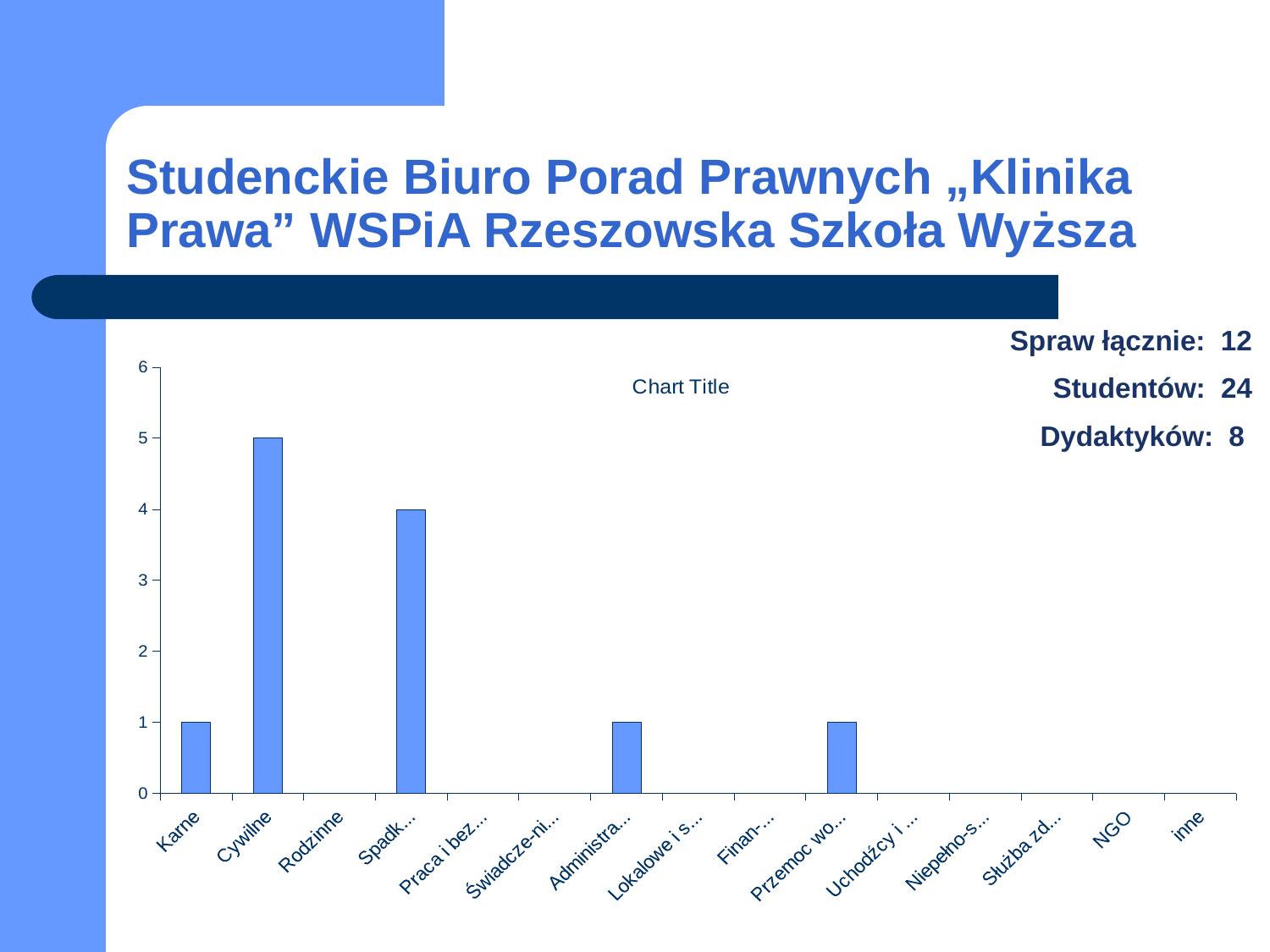
What is the title shown on the chart? Chart Title What is the value for the Administra... category? 1 What is the difference between the values for Cywilne and Spadk...? 1 What is the value for the Spadk... category? 4 Which is larger, the value for Cywilne or the value for Spadk...? Cywilne How many categories are shown on the x axis? 15 Is the value for Cywilne greater or less than 3? greater What type of chart is shown on the slide? bar chart What is the value for the Przemoc wo... category? 1 What is the value for Karne? 1 Which category has the highest value? Cywilne What is the value for Cywilne? 5